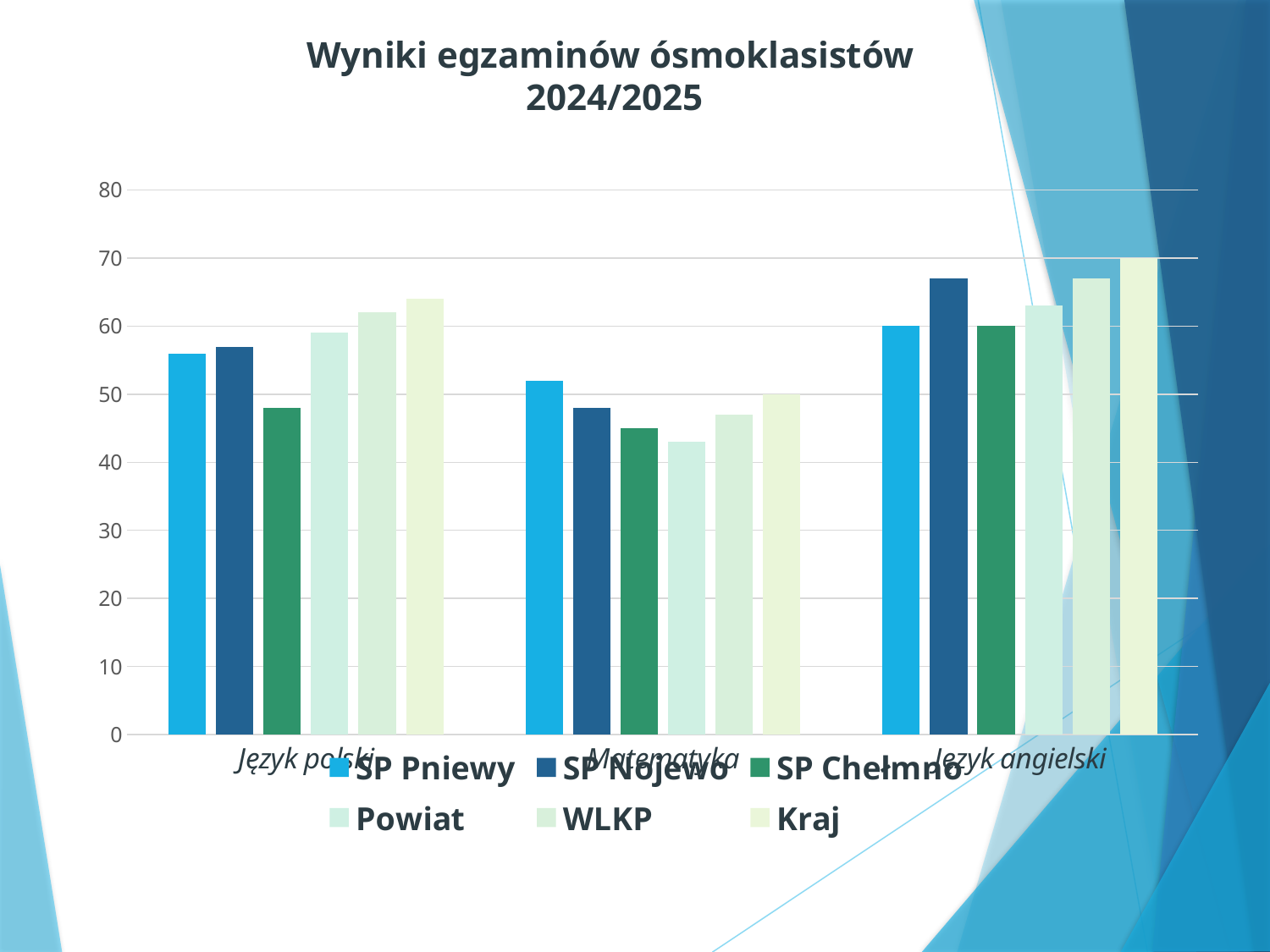
How many series does the legend list? 6 What kind of chart is shown on the slide? bar chart For SP Chełmno, is the value higher in Język polski or in Język angielski? Język angielski Is the value for SP Chełmno in Język polski greater or less than 50? less Which series has the lowest value in Język polski? SP Chełmno Is the value for SP Nojewo in Język angielski greater or less than 60? greater For SP Pniewy, is the value higher in Język polski or in Matematyka? Język polski What is the title of the chart? Wyniki egzaminów ósmoklasistów 2024/2025 Is the value for Powiat in Matematyka greater or less than 50? less How many subject categories are shown on the x axis? 3 Which series has the highest value in Język angielski? Kraj